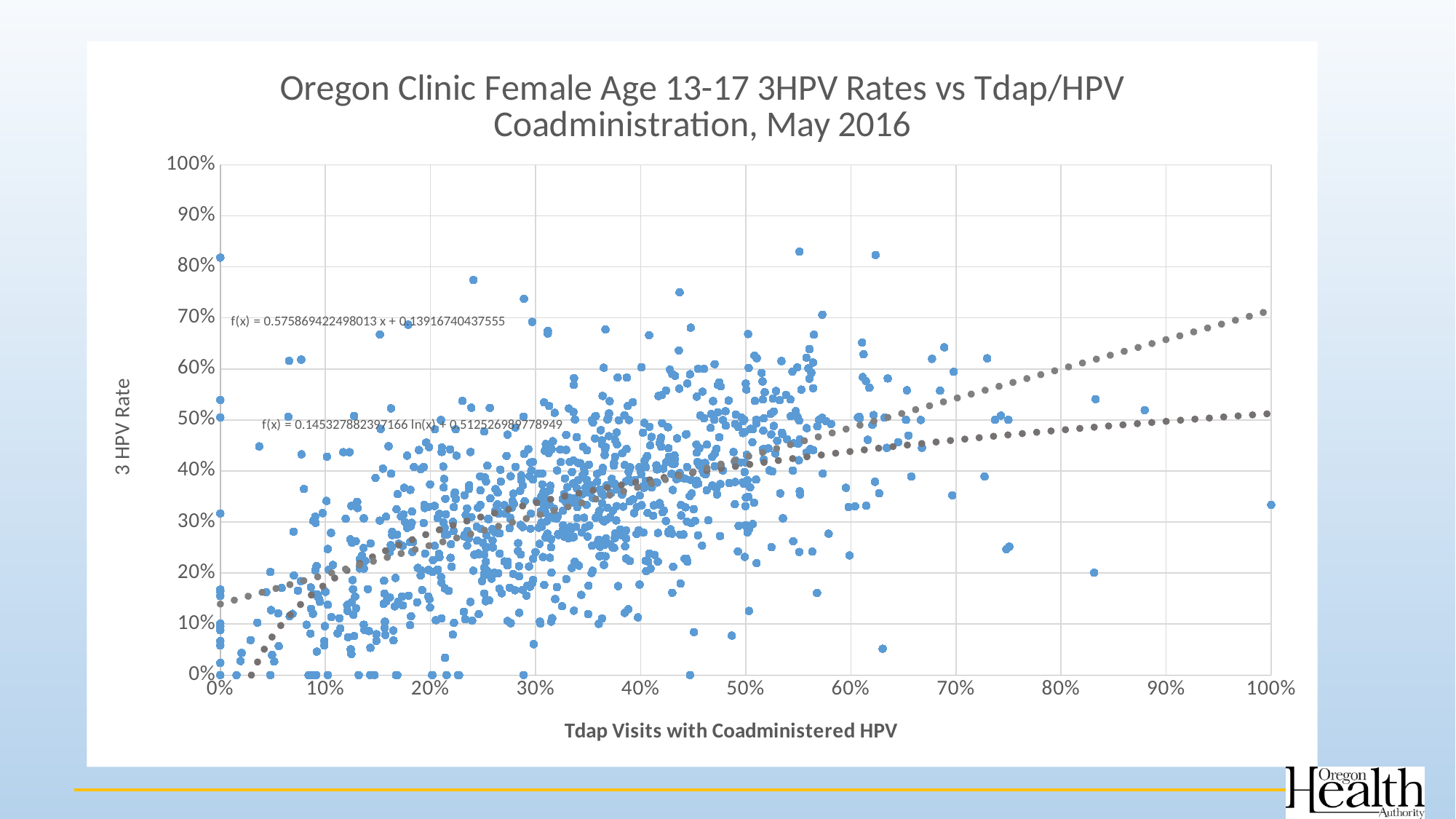
What is the label of the x axis? Tdap Visits with Coadministered HPV As the share of Tdap visits with coadministered HPV increases along the x axis, do the 3 HPV rates generally rise or fall? rise How many trendlines are drawn on the chart? 2 What kind of chart is shown on the slide? scatter plot What is the title of the chart? Oregon Clinic Female Age 13-17 3HPV Rates vs Tdap/HPV Coadministration, May 2016 What is the equation of the logarithmic trendline printed on the chart? f(x) = 0.145327882397166 ln(x) + 0.512526989778949 At 100% on the x axis, is the linear trendline greater or less than 60%? greater What is the highest value shown on the y axis? 100% At 100% on the x axis, is the logarithmic trendline greater or less than 60%? less At 100% on the x axis, which trendline is higher, the linear one or the logarithmic one? the linear one What is the equation of the linear trendline printed on the chart? f(x) = 0.575869422498013 x + 0.13916740437555